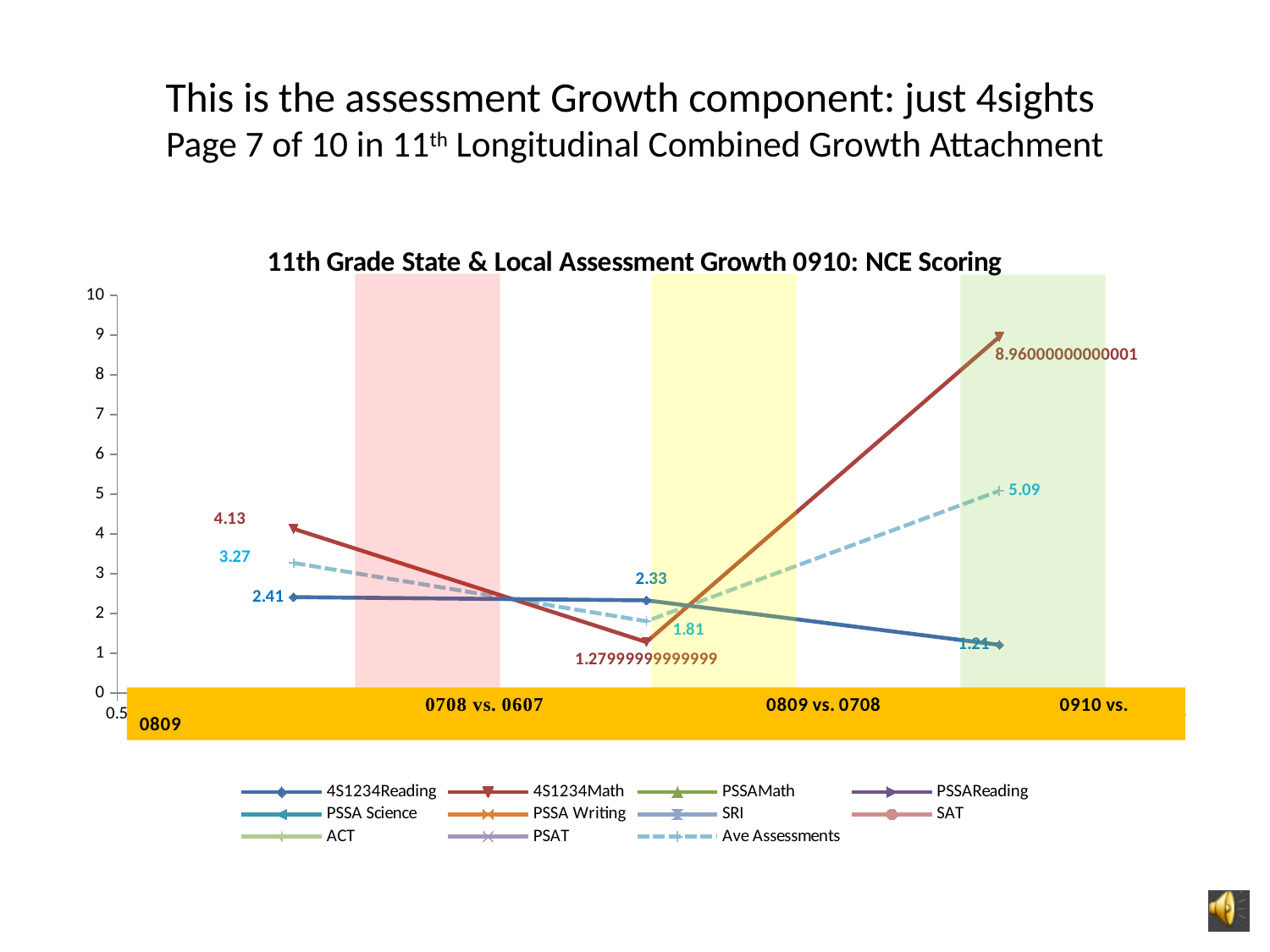
What is the value for 4S1234Reading at 0910 vs. 0809? 1.21 What is the value for Ave Assessments at 0910 vs. 0809? 5.09 What is the value for 4S1234Reading at 0708 vs. 0607? 2.41 How many series does the chart legend list? 11 What is the value for Ave Assessments at 0809 vs. 0708? 1.81 At which x-axis category does 4S1234Math reach its highest value? 0910 vs. 0809 Which is larger at 0708 vs. 0607: 4S1234Math or Ave Assessments? 4S1234Math What is the difference between the 4S1234Reading values at 0708 vs. 0607 and 0910 vs. 0809? 1.20 What is the value for 4S1234Math at 0708 vs. 0607? 4.13 What type of chart is shown on the slide? line chart What is the title of the chart? 11th Grade State & Local Assessment Growth 0910: NCE Scoring Does the 4S1234Reading line rise or fall from 0708 vs. 0607 to 0910 vs. 0809? fall